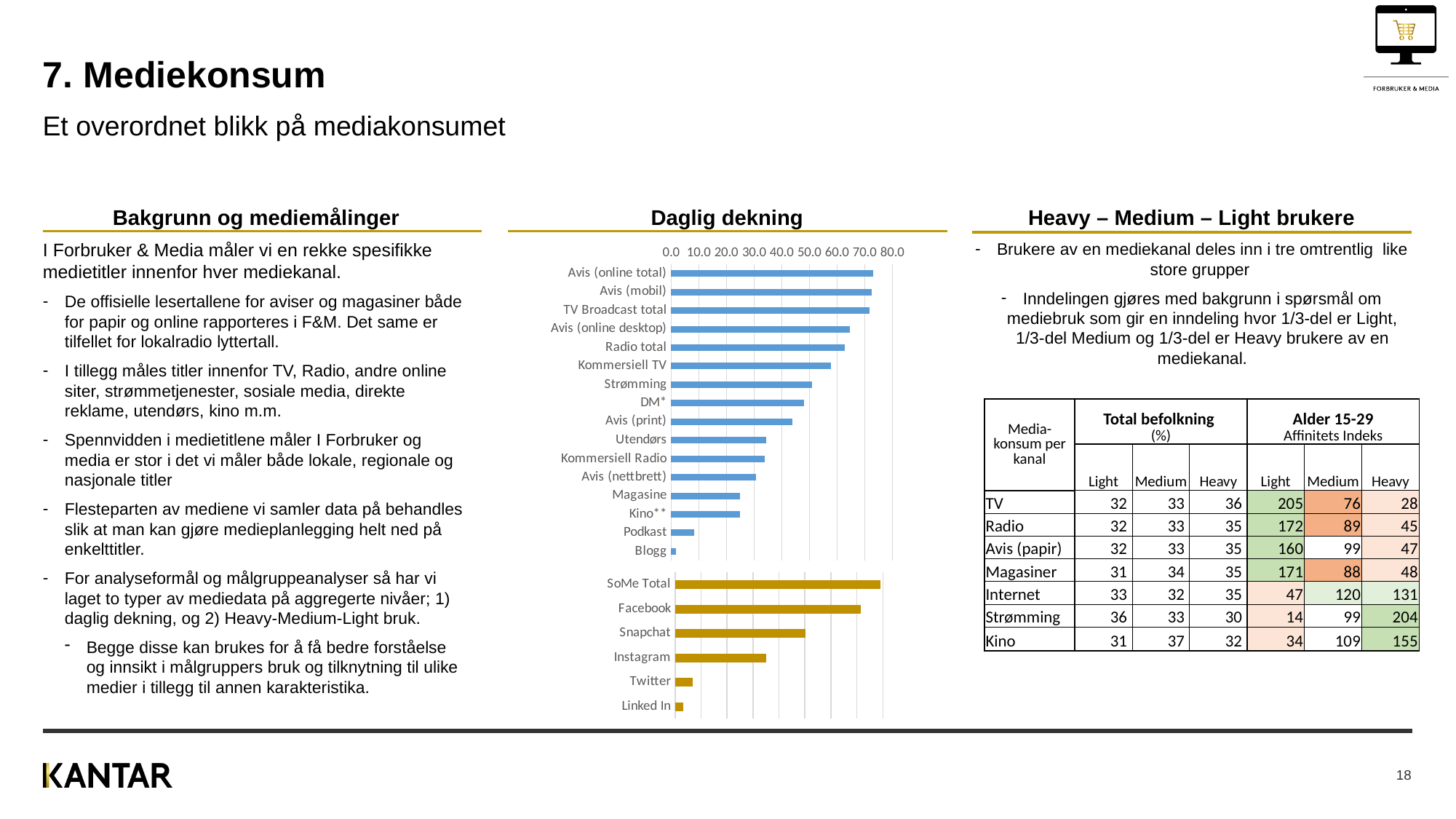
In the bottom chart under "Daglig dekning", which is larger, Facebook or Snapchat? Facebook How many categories are shown in the bottom chart under "Daglig dekning"? 6 In the top chart under "Daglig dekning", is the value for Podkast greater or less than 10.0? less What kind of chart is the top chart under "Daglig dekning"? bar chart In the top chart under "Daglig dekning", is the value for Avis (online total) greater or less than 60.0? greater In the top chart under "Daglig dekning", is the value for Utendørs greater or less than 40.0? less In the top chart under "Daglig dekning", which is larger, Kommersiell TV or Avis (print)? Kommersiell TV In the bottom chart under "Daglig dekning", which category has the lowest value? Linked In In the top chart under "Daglig dekning", which category has the lowest value? Blogg In the bottom chart under "Daglig dekning", which category has the highest value? SoMe Total